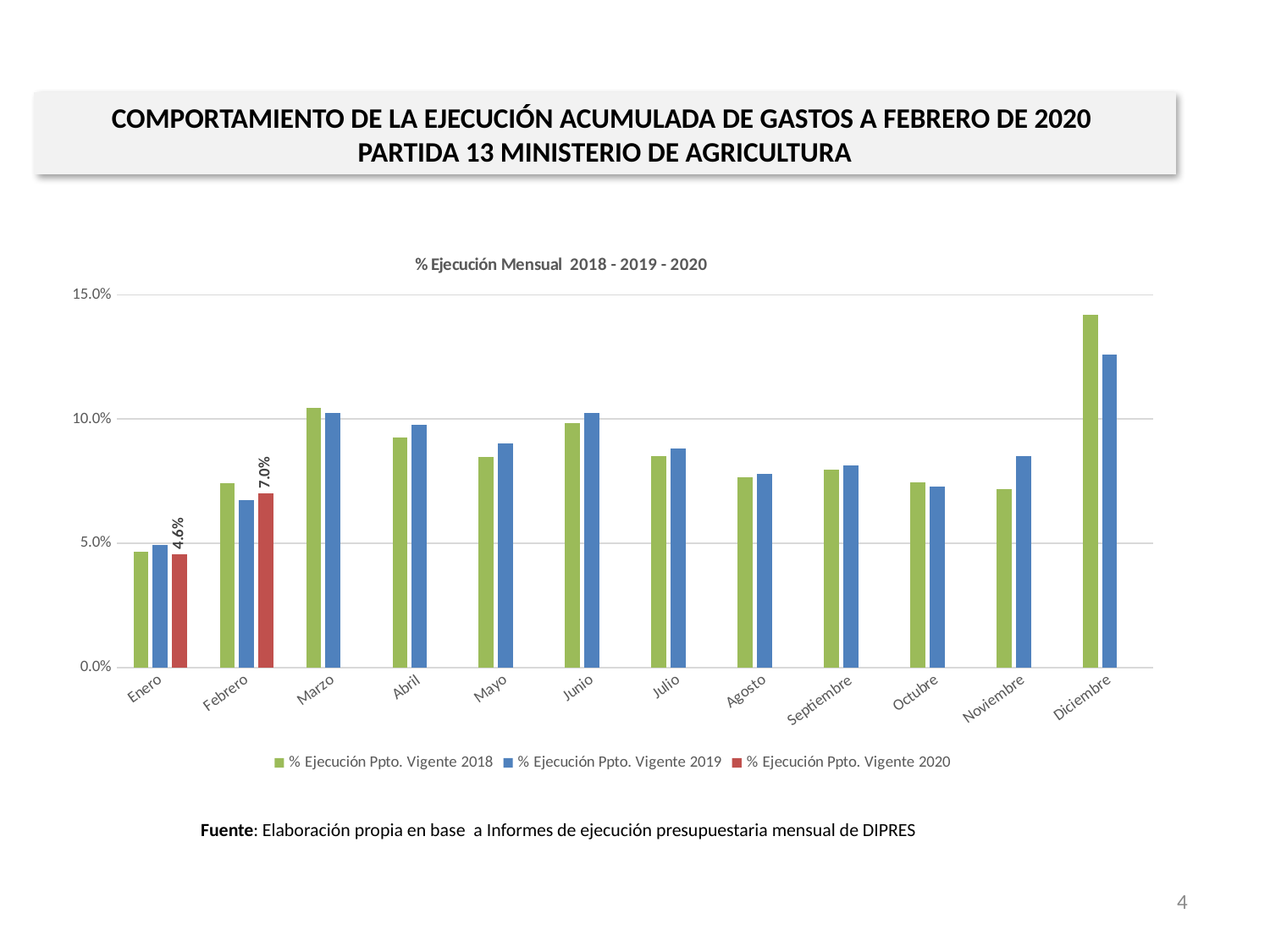
Which is larger for the 2020 series: the value in Enero or the value in Febrero? Febrero What kind of chart is shown on the slide? bar chart Which month has the highest value for % Ejecución Ppto. Vigente 2018? Diciembre Is the value for % Ejecución Ppto. Vigente 2018 in Diciembre greater or less than 10.0%? greater What is the value for % Ejecución Ppto. Vigente 2020 in Febrero? 7.0% Which month has the lowest value for % Ejecución Ppto. Vigente 2018? Enero How many months are shown on the x axis? 12 By how much does the 2020 value in Febrero exceed the 2020 value in Enero? 2.4% Does the 2020 series rise or fall from Enero to Febrero? rises What is the title of the chart? % Ejecución Mensual 2018 - 2019 - 2020 How many series does the legend list? 3 What is the value for % Ejecución Ppto. Vigente 2020 in Enero? 4.6%